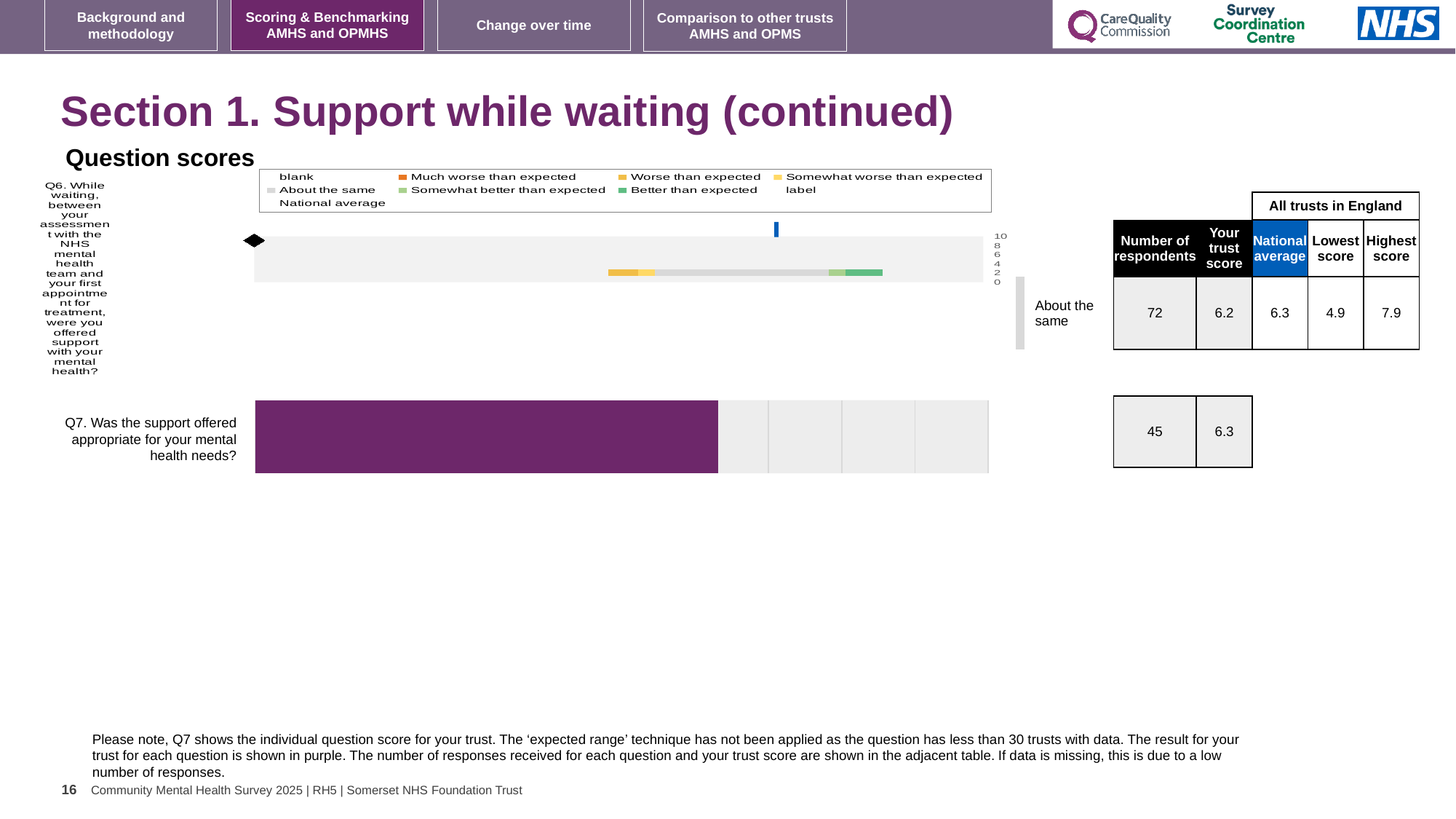
How many respondents answered Q6? 72 What is the national average score for Q6? 6.3 What colour is used for the 'Better than expected' category in the legend? Green What is the lowest score among all trusts in England for Q6? 4.9 What is the trust score for Q6 shown in the table next to the chart? 6.2 Which expected-range category is the trust's Q6 result placed in? About the same What is the trust score for Q7? 6.3 How many more respondents answered Q6 than Q7? 27 What is the highest score among all trusts in England for Q6? 7.9 Which question has the higher trust score, Q6 or Q7? Q7 What is the difference between the highest and lowest trust scores in England for Q6? 3.0 What kind of chart is used to show the question scores? Bar chart